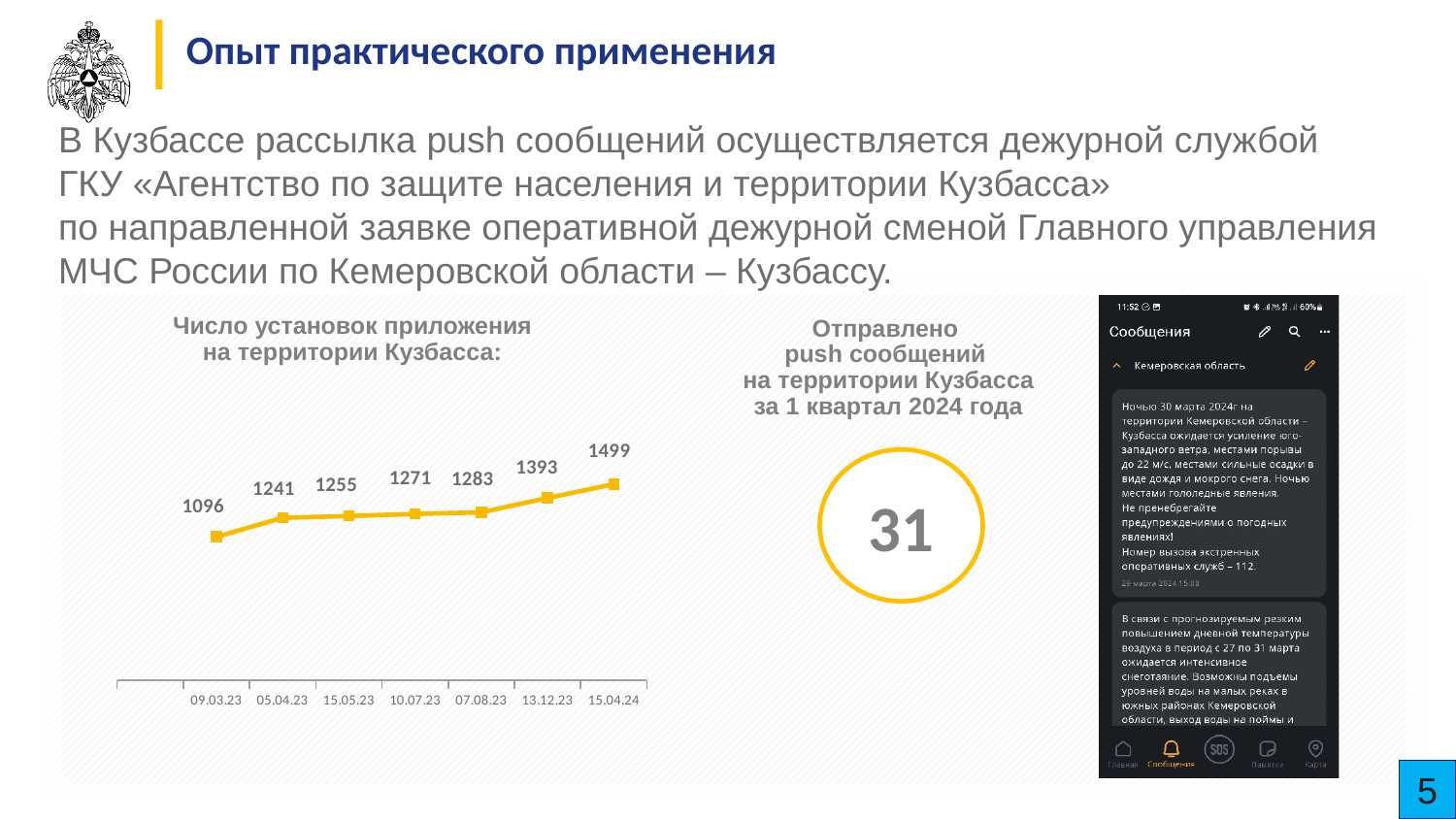
Do the values on the app installations chart rise or fall from left to right? rise What is the difference between the number of installations on 15.04.24 and on 09.03.23? 403 Which is larger: the number of installations on 05.04.23 or on 15.05.23? 15.05.23 On which date is the number of app installations highest? 15.04.24 What is the number of app installations on 10.07.23? 1271 On which date is the number of app installations lowest? 09.03.23 What is the number of app installations on 09.03.23? 1096 What is the difference between the number of installations on 13.12.23 and on 07.08.23? 110 How many data points are plotted on the app installations chart? 7 What type of chart is used to show the number of app installations in Kuzbass? line chart What is the number of app installations on 13.12.23? 1393 What is the number of app installations on 15.04.24? 1499